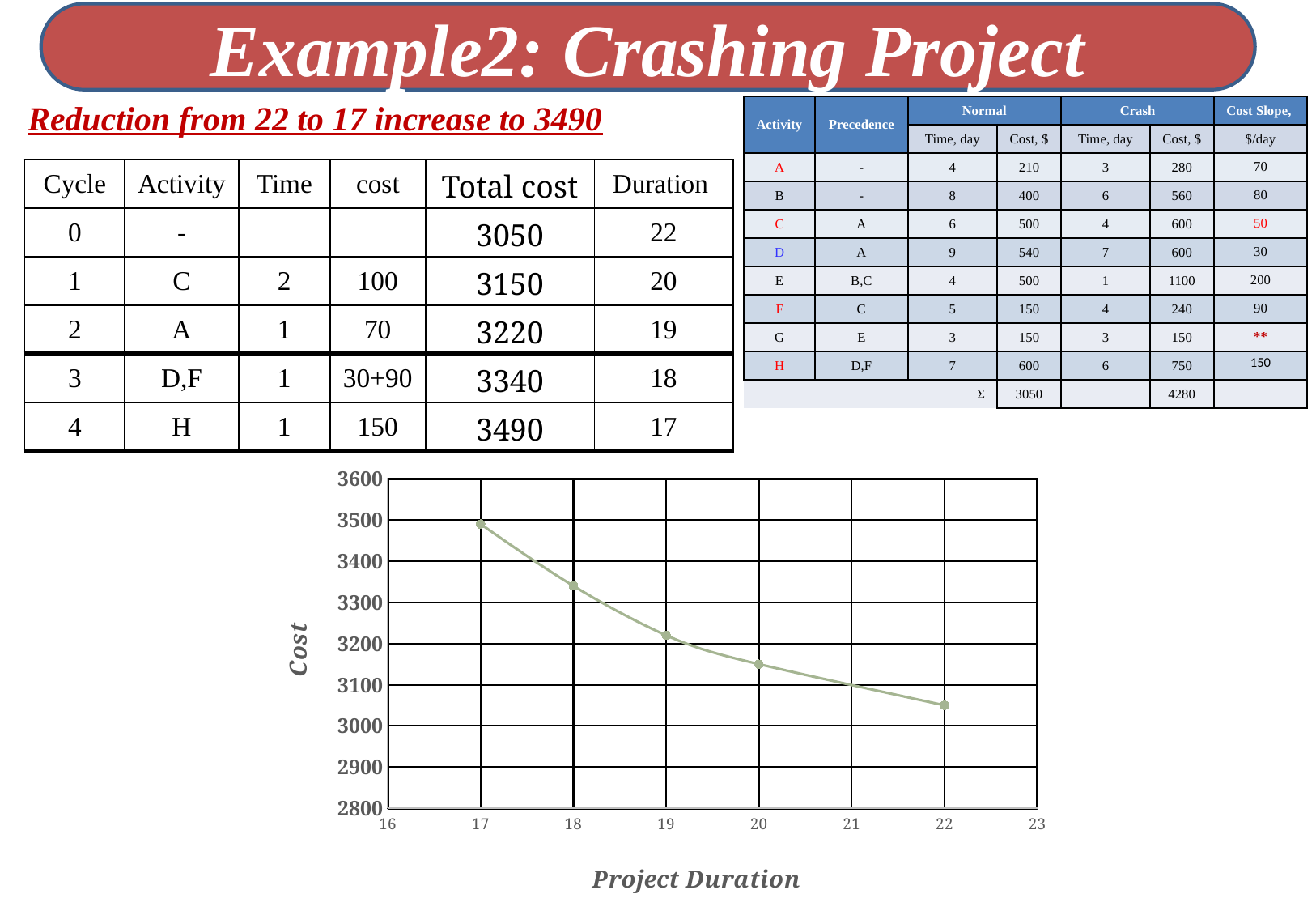
How many data points are plotted on the chart? 5 What is the label of the x axis of the chart? Project Duration At which project duration is the plotted cost lowest? 22 Is the cost at a project duration of 22 greater or less than 3100? less What is the label of the y axis of the chart? Cost Is the cost at a project duration of 19 greater or less than 3300? less At which project duration is the plotted cost highest? 17 Is the cost at a project duration of 17 greater or less than 3400? greater As project duration increases along the x axis, does the cost rise or fall? fall What kind of chart is shown on the slide? line chart What is the cost plotted at a project duration of 17? 3490 Which has the higher cost on the chart, a project duration of 18 or 20? 18